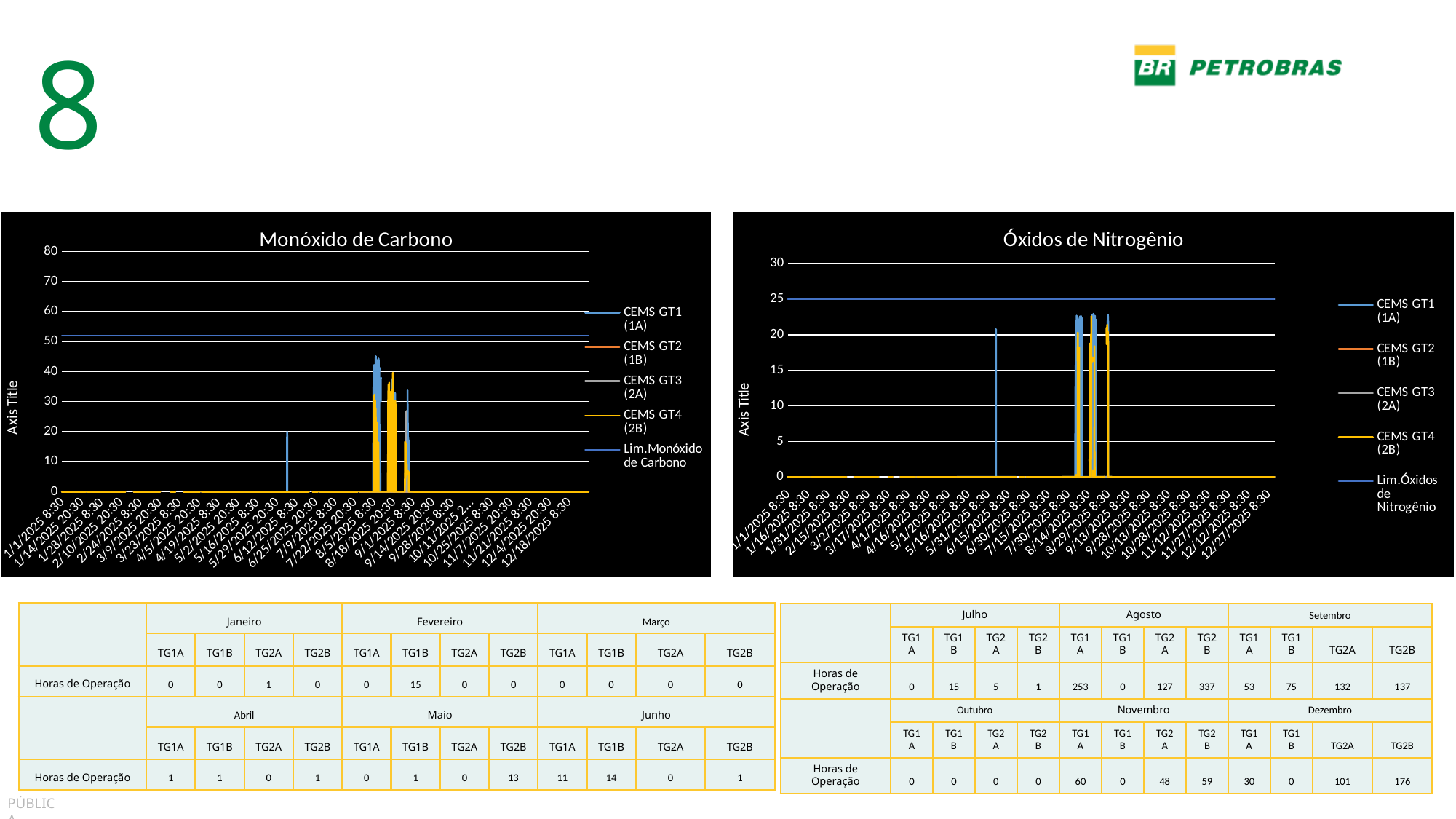
How many series does the legend of the Monóxido de Carbono chart list? 5 What is the title of the chart on the right of the slide? Óxidos de Nitrogênio What is the last entry in the legend of the Monóxido de Carbono chart? Lim.Monóxido de Carbono In the Monóxido de Carbono chart, is the highest peak of CEMS GT1 (1A) greater or less than 40? greater In the Monóxido de Carbono chart, is the highest peak of CEMS GT1 (1A) greater or less than 50? less How many series does the legend of the Óxidos de Nitrogênio chart list? 5 In the Óxidos de Nitrogênio chart, is the Lim.Óxidos de Nitrogênio line greater or less than 20? greater What kind of chart is the Monóxido de Carbono chart? line chart